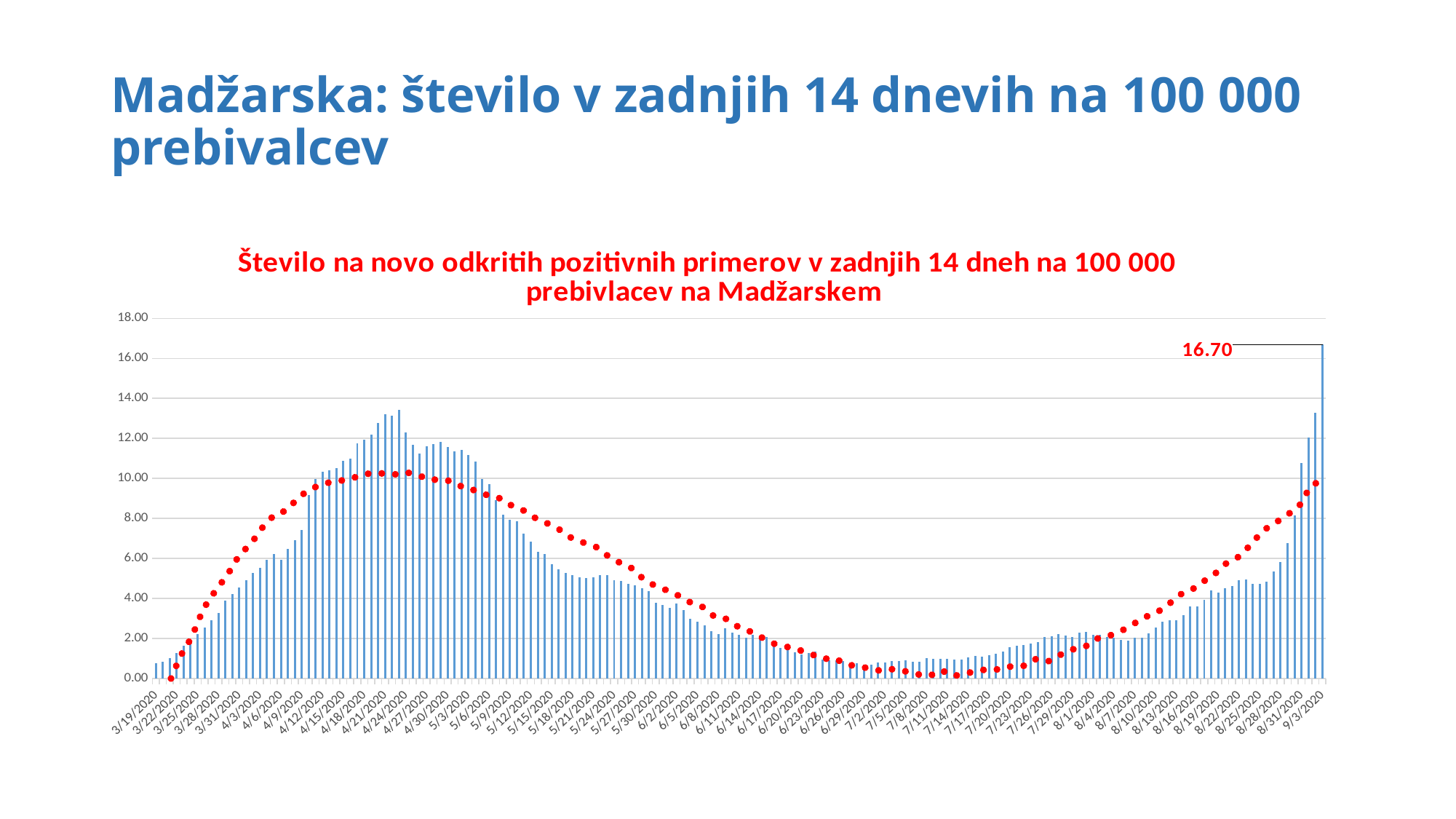
Do the values rise or fall between 7/8/2020 and 9/3/2020? rise What colour are the bars in the chart? blue Do the values rise or fall between 4/24/2020 and 7/8/2020? fall Is the value for 6/14/2020 greater or less than 4.00? less What kind of chart is shown on the slide? bar chart Is the value for 7/8/2020 greater or less than 2.00? less Is the value for 8/31/2020 greater or less than 8.00? greater What is the value shown for 9/3/2020? 16.70 Which date has the highest bar in the chart? 9/3/2020